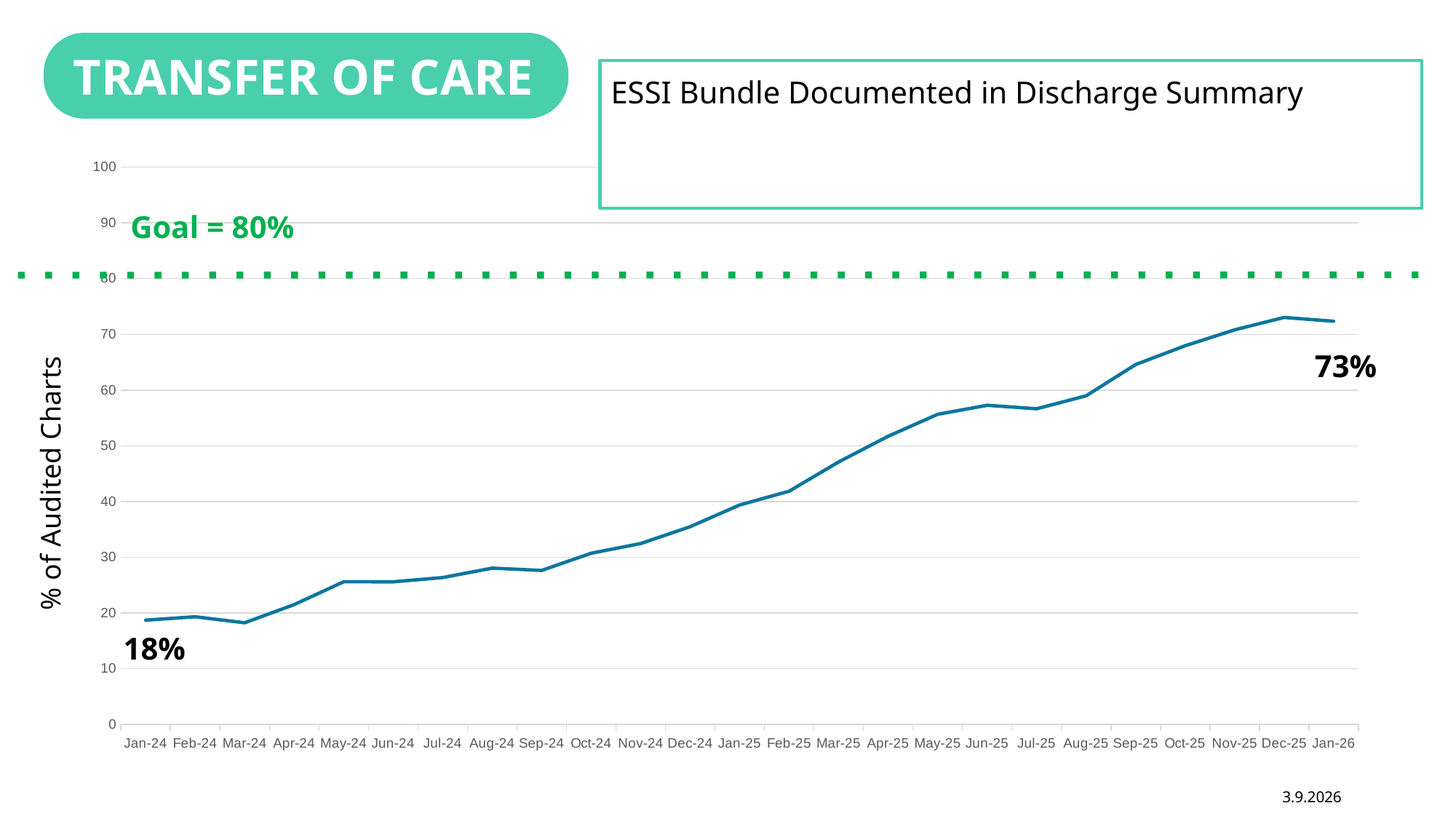
What goal value is marked by the dotted line on the chart? 80% Does the line generally rise or fall from Jan-24 to Jan-26? rise How many months are plotted along the x axis? 25 What value is labelled at the end of the line, near Dec-25/Jan-26? 73% What kind of chart is shown on the slide? line chart Is the value for Apr-24 greater or less than 30? less What is the difference between the labelled end value (73%) and the labelled start value (18%)? 55 percentage points Is the value for Jul-25 greater or less than 50? greater What value is labelled at the start of the line, at Jan-24? 18% Which is larger, the value for May-24 or the value for Nov-24? Nov-24 What is the title of the chart? ESSI Bundle Documented in Discharge Summary Is the value for Dec-25 greater or less than 80? less